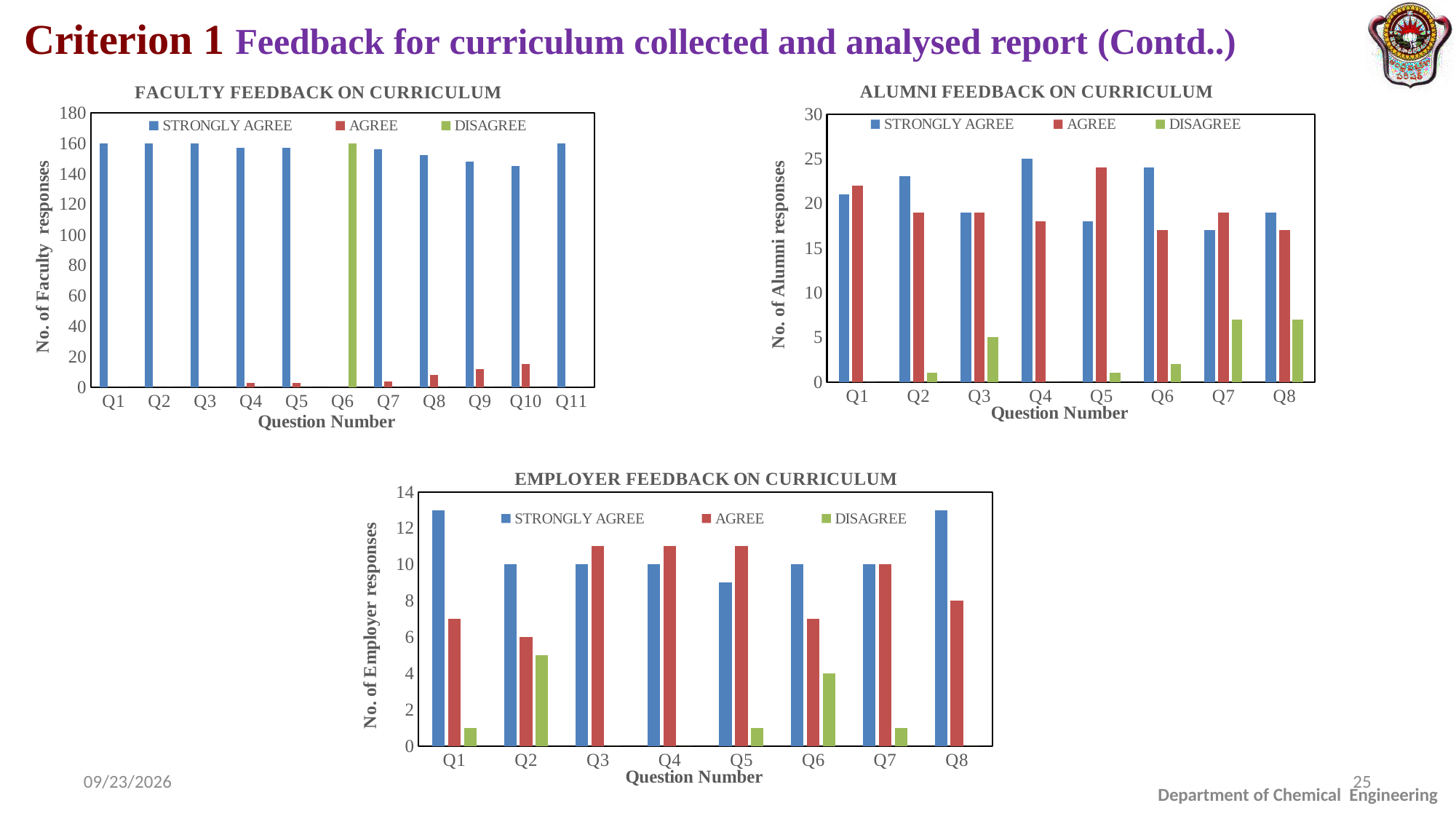
In the EMPLOYER FEEDBACK ON CURRICULUM chart, what is the DISAGREE value for Q6? 4 In the ALUMNI FEEDBACK ON CURRICULUM chart, which question has the highest STRONGLY AGREE value? Q4 In the FACULTY FEEDBACK ON CURRICULUM chart, is the AGREE value for Q10 greater or less than 20? less How many question categories are shown on the x axis of the ALUMNI FEEDBACK ON CURRICULUM chart? 8 In the EMPLOYER FEEDBACK ON CURRICULUM chart, which is larger for Q1: STRONGLY AGREE or AGREE? STRONGLY AGREE What type of chart is the FACULTY FEEDBACK ON CURRICULUM chart? bar chart In the FACULTY FEEDBACK ON CURRICULUM chart, what is the STRONGLY AGREE value for Q1? 160 How many series does the legend of the FACULTY FEEDBACK ON CURRICULUM chart list? 3 How many question categories are shown on the x axis of the FACULTY FEEDBACK ON CURRICULUM chart? 11 In the ALUMNI FEEDBACK ON CURRICULUM chart, what is the DISAGREE value for Q3? 5 In the EMPLOYER FEEDBACK ON CURRICULUM chart, what is the AGREE value for Q8? 8 In the ALUMNI FEEDBACK ON CURRICULUM chart, what is the STRONGLY AGREE value for Q4? 25